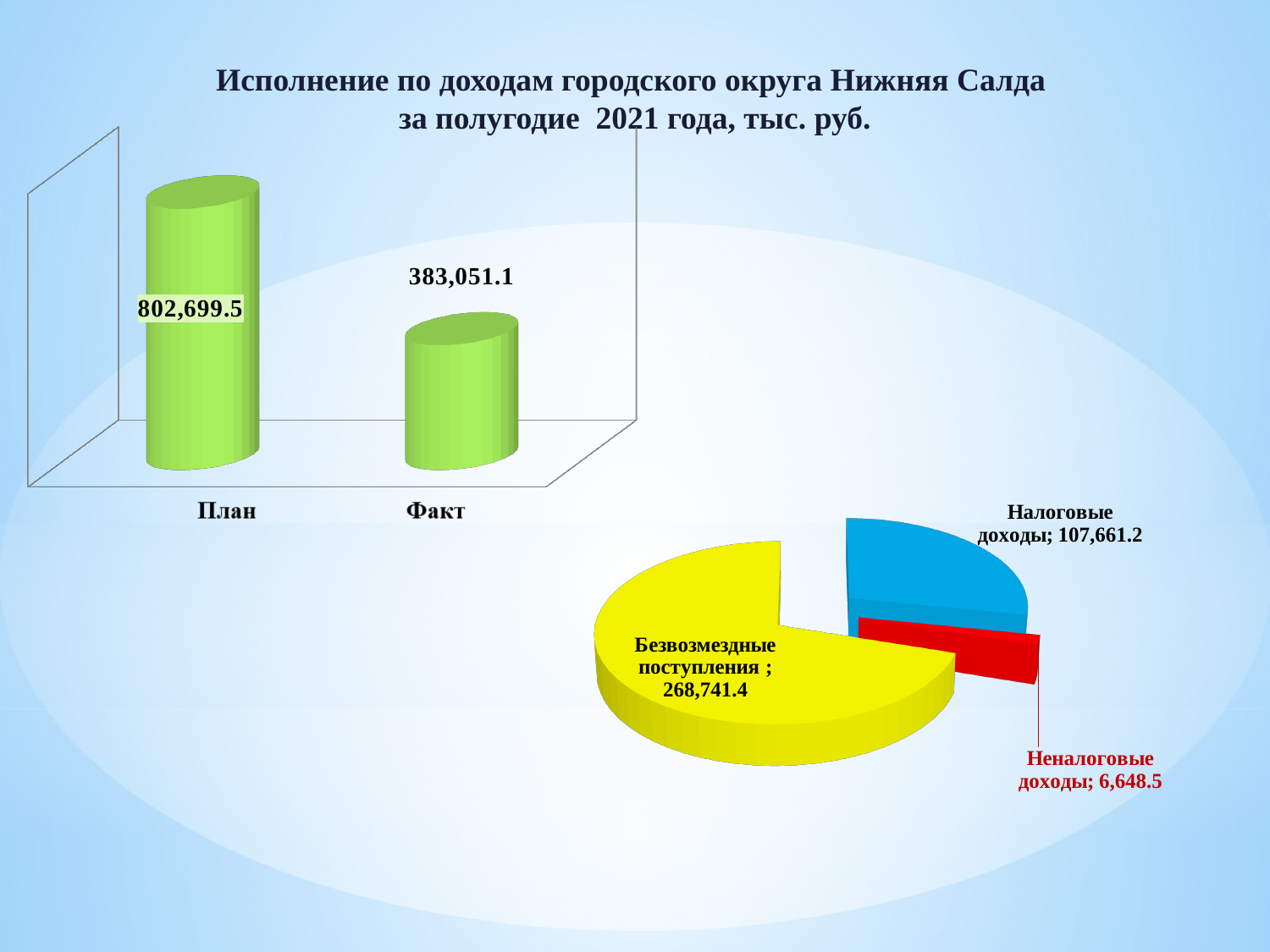
In the bar chart at the top left, which category has the higher value, План or Факт? План In the bar chart at the top left, what is the value for Факт? 383,051.1 In the pie chart at the bottom right, what colour is the Безвозмездные поступления slice? Yellow In the pie chart at the bottom right, which slice is the largest? Безвозмездные поступления In the bar chart at the top left, how many categories are shown? 2 In the pie chart at the bottom right, what is the value for Налоговые доходы? 107,661.2 In the pie chart at the bottom right, which slice is the smallest? Неналоговые доходы In the pie chart at the bottom right, what is the total of all three slices? 383,051.1 In the bar chart at the top left, what is the difference between the План and Факт values? 419,648.4 In the bar chart at the top left, what is the value for План? 802,699.5 In the pie chart at the bottom right, what is the value for Неналоговые доходы? 6,648.5 What kind of chart is shown at the top left of the slide? Bar chart